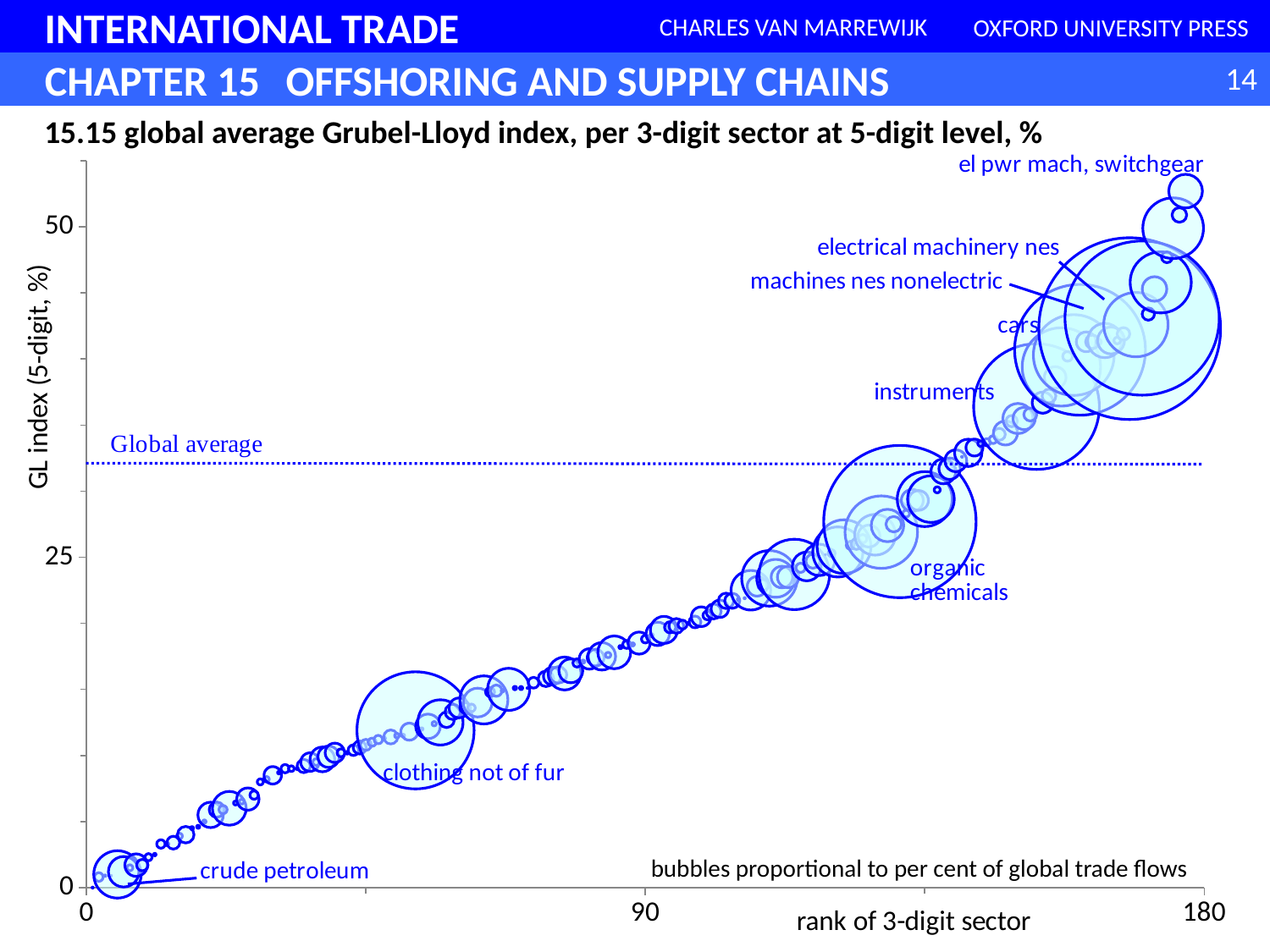
Which has a higher GL index, crude petroleum or cars? cars According to the note on the chart, what are the bubble sizes proportional to? per cent of global trade flows Which labeled sector has the highest GL index? el pwr mach, switchgear Do the GL index values rise or fall as the rank of 3-digit sector increases along the x axis? rise Is the GL index for cars greater or less than 25? greater Is the GL index for crude petroleum greater or less than 25? less Is the GL index for instruments greater or less than 25? greater Which has a higher GL index, clothing not of fur or instruments? instruments What kind of chart is shown on the slide? bubble chart Which labeled sector has the lowest GL index? crude petroleum